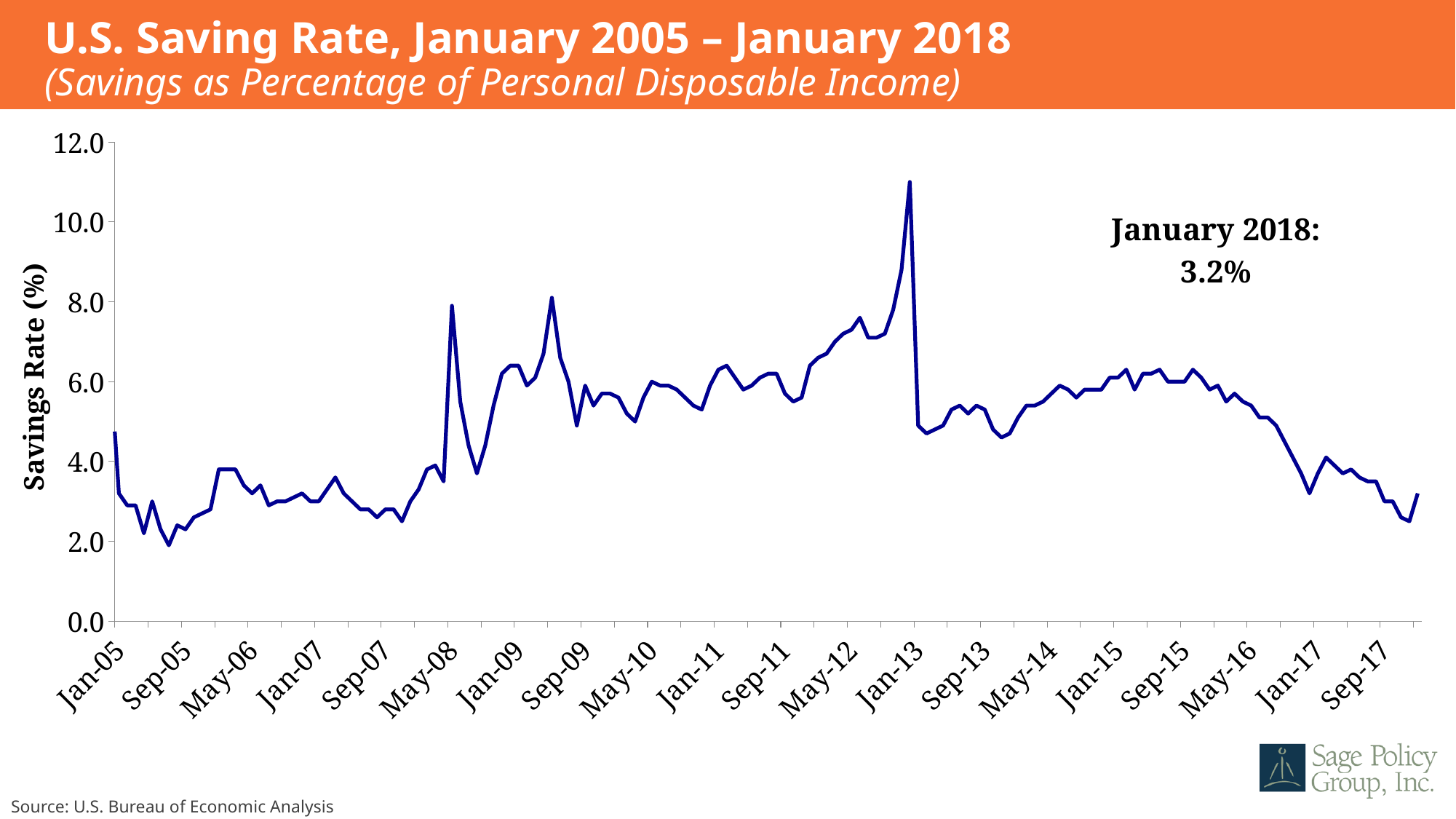
What kind of chart is shown on the slide? Line chart Between Jan-07 and Jan-09, does the saving rate generally rise or fall? rise Which is larger, the value at Sep-05 or the value at Sep-15? Sep-15 Is the value for Jan-15 greater or less than 4.0? greater Is the highest point on the chart greater or less than 10.0? greater Between Jan-15 and Jan-18, does the saving rate generally rise or fall? fall What is the title of the vertical axis? Savings Rate (%) Is the value for Sep-17 greater or less than 6.0? less How many data series are plotted on the chart? 1 What is the saving rate for January 2018 as labelled on the chart? 3.2%